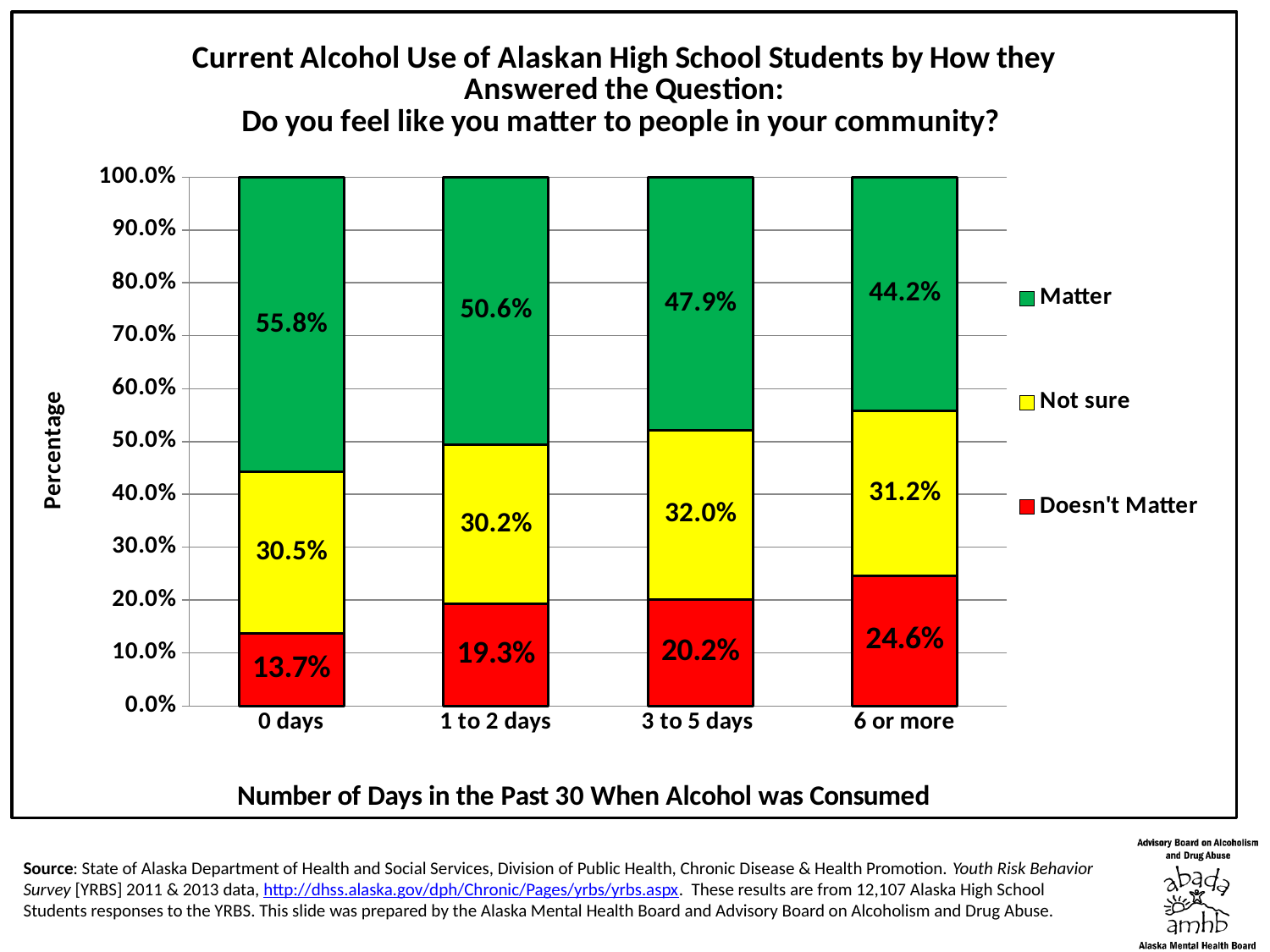
How many series does the legend list? 3 How many categories are shown on the x axis? 4 Which category has the highest "Matter" percentage? 0 days What percentage of students who drank on 6 or more days answered "Doesn't Matter"? 24.6% What is the difference between the "Matter" percentages for 0 days and 6 or more? 11.6% What is the "Not sure" value for the 3 to 5 days category? 32.0% Which is larger: the "Doesn't Matter" value for 1 to 2 days or for 6 or more? 6 or more What kind of chart is shown? Stacked bar chart What colour represents the "Not sure" series? Yellow Does the "Matter" percentage rise or fall as the number of drinking days increases? Fall What percentage of students who drank on 0 days answered "Matter"? 55.8% Which category has the lowest "Doesn't Matter" percentage? 0 days